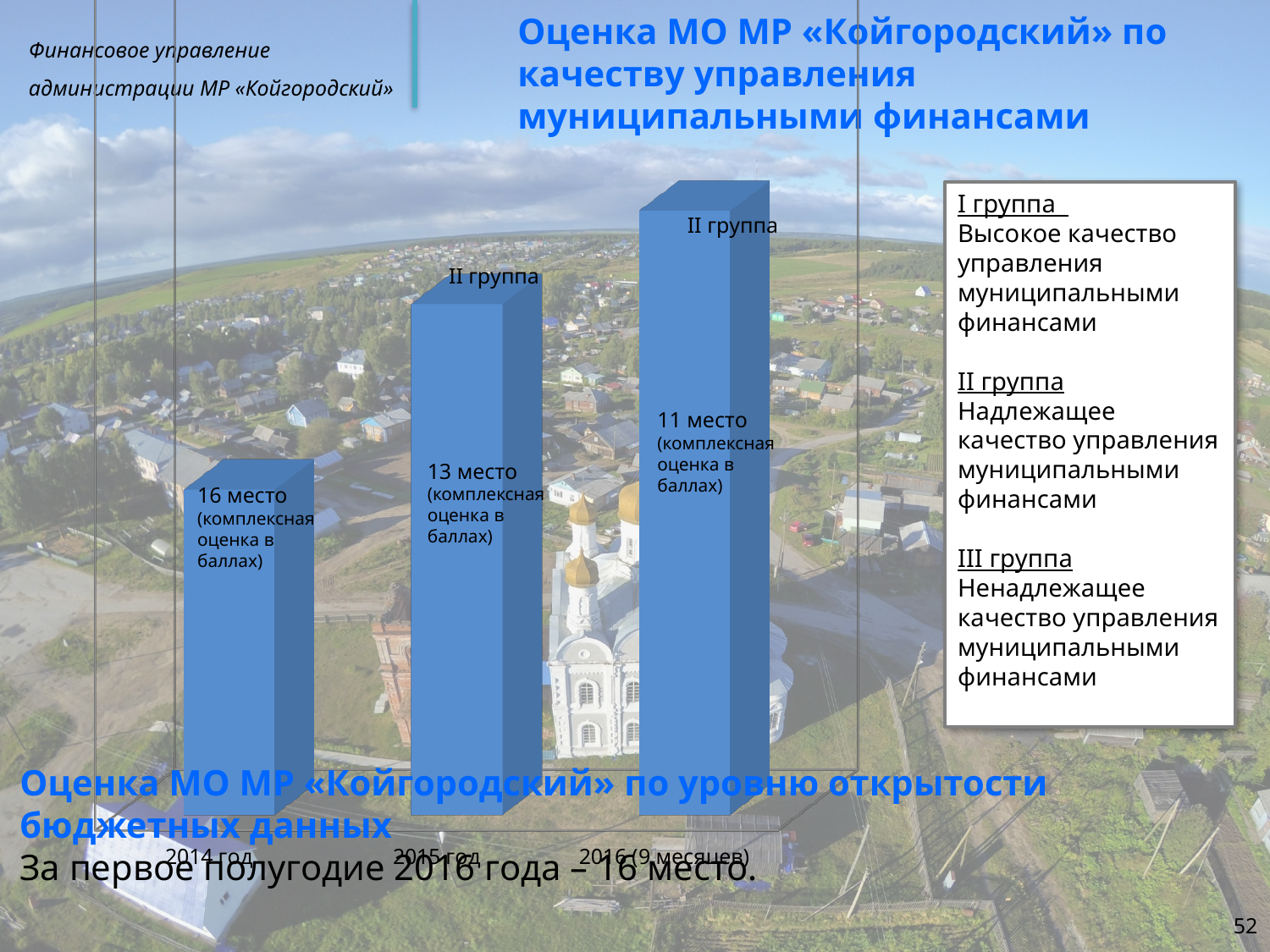
What place is shown for 2016 (9 месяцев) in the chart? 11 место By how many places did the ranking improve from 2014 год (16 место) to 2016 (9 месяцев) (11 место)? 5 What kind of chart is shown on the slide? Bar chart Which bar is taller, 2014 год or 2015 год? 2015 год How many bars (categories) does the chart show? 3 Which category has the tallest bar? 2016 (9 месяцев) What place is shown for 2015 год in the chart? 13 место Do the bars rise or fall from 2014 год to 2016 (9 месяцев)? Rise What is the title of the chart at the top of the slide? Оценка МО МР «Койгородский» по качеству управления муниципальными финансами What place is shown for 2014 год in the chart? 16 место Which group label is shown above the 2015 год and 2016 (9 месяцев) bars? II группа Which category has the shortest bar? 2014 год